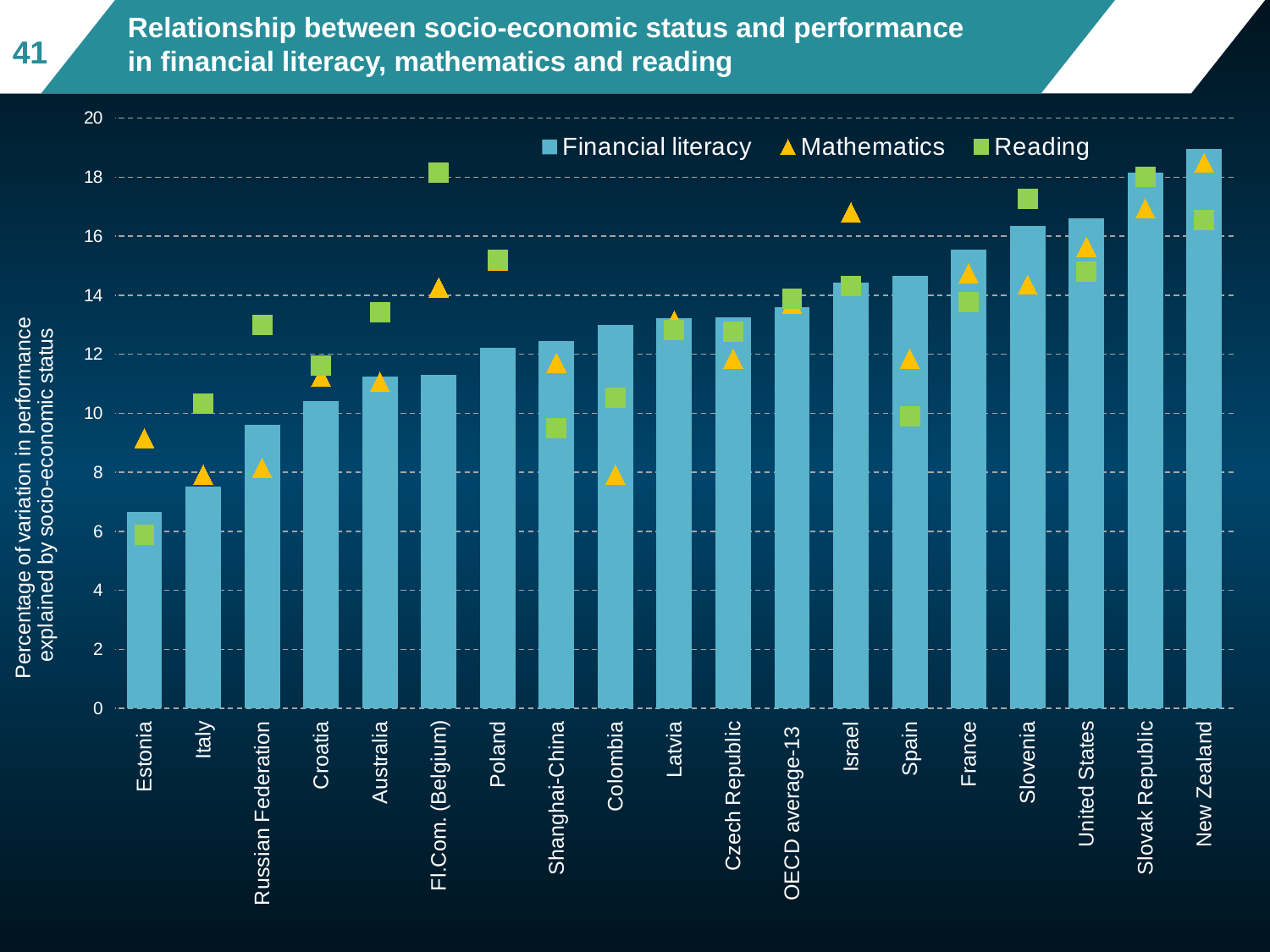
Which category has the highest Financial literacy bar? New Zealand Which category has the lowest Financial literacy bar? Estonia Is the Mathematics value for Colombia greater or less than 10? less Which category has the lowest Reading value? Estonia Which category has the highest Mathematics value? New Zealand Is the Financial literacy value for Estonia greater or less than 8? less How many countries/categories are shown on the x axis? 19 What kind of chart is shown on the slide? Bar chart with markers Which has the larger Financial literacy value, Slovenia or Italy? Slovenia How many series does the legend list? 3 Do the Financial literacy bars generally rise or fall from left to right along the x axis? rise